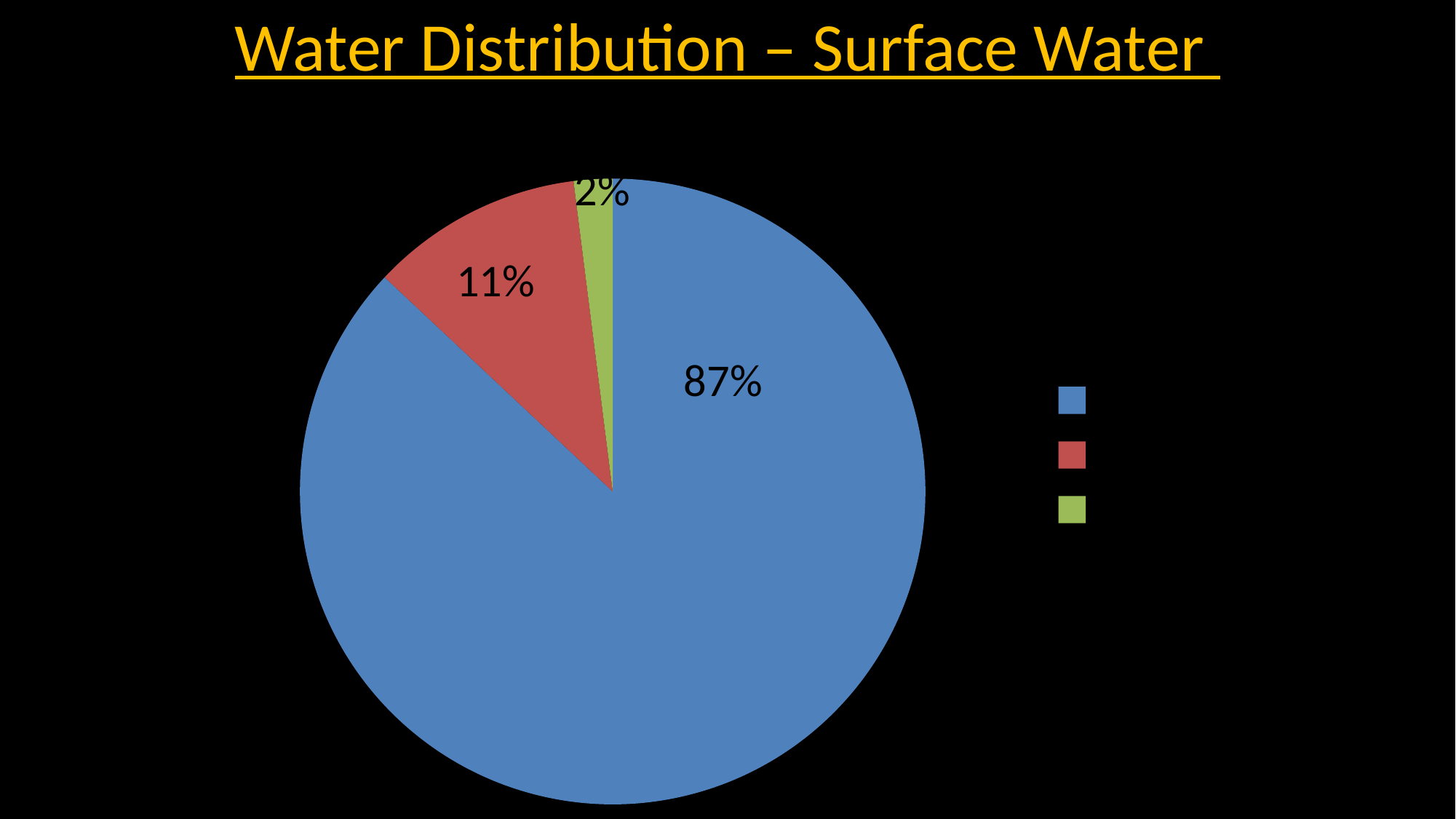
What percentage is shown on the green slice of the pie chart? 2% What percentage is shown on the red slice of the pie chart? 11% What percentage is shown on the blue slice of the pie chart? 87% Which colour slice is the smallest in the pie chart? green How many entries does the legend list? 3 What is the difference in percentage points between the red slice and the green slice? 9 What kind of chart is shown on the slide? pie chart What is the title of the slide? Water Distribution – Surface Water Which is larger, the red slice or the green slice? red Which colour slice is the largest in the pie chart? blue How many slices does the pie chart have? 3 What is the difference in percentage points between the blue slice and the red slice? 76